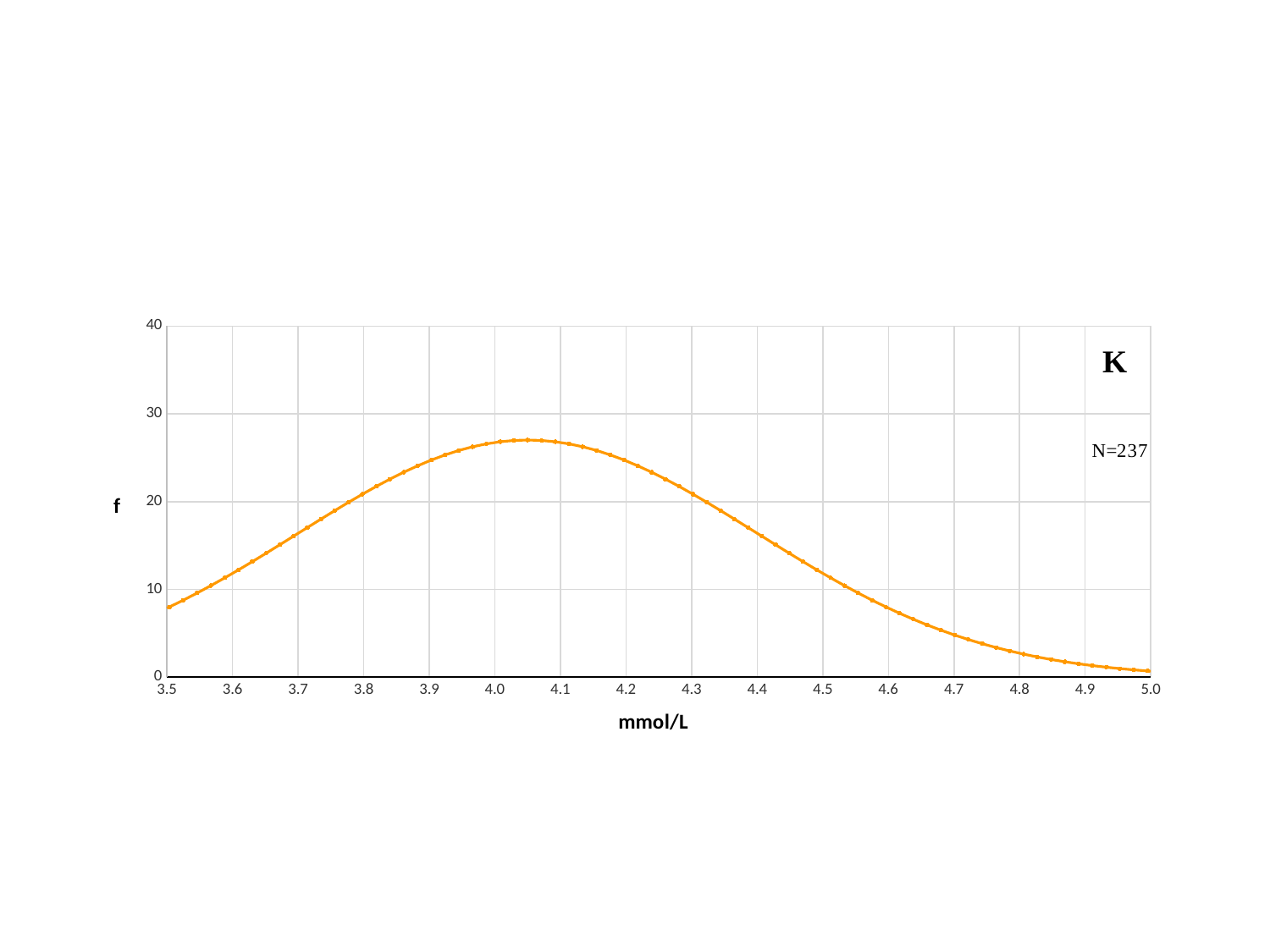
Does the curve rise or fall as mmol/L increases from 3.5 to 4.0? rise Which has the larger value of f: 3.7 mmol/L or 4.5 mmol/L? 3.7 mmol/L Is the value of f at 4.7 mmol/L greater or less than 10? less What sample size (N) is printed on the chart? N=237 How many data series are plotted on the chart? 1 What is the title of the chart? K Does the curve rise or fall as mmol/L increases from 4.2 to 5.0? fall Is the peak value of the curve greater or less than 30? less What kind of chart is shown on the slide? line chart Is the value of f at 5.0 mmol/L greater or less than 5? less